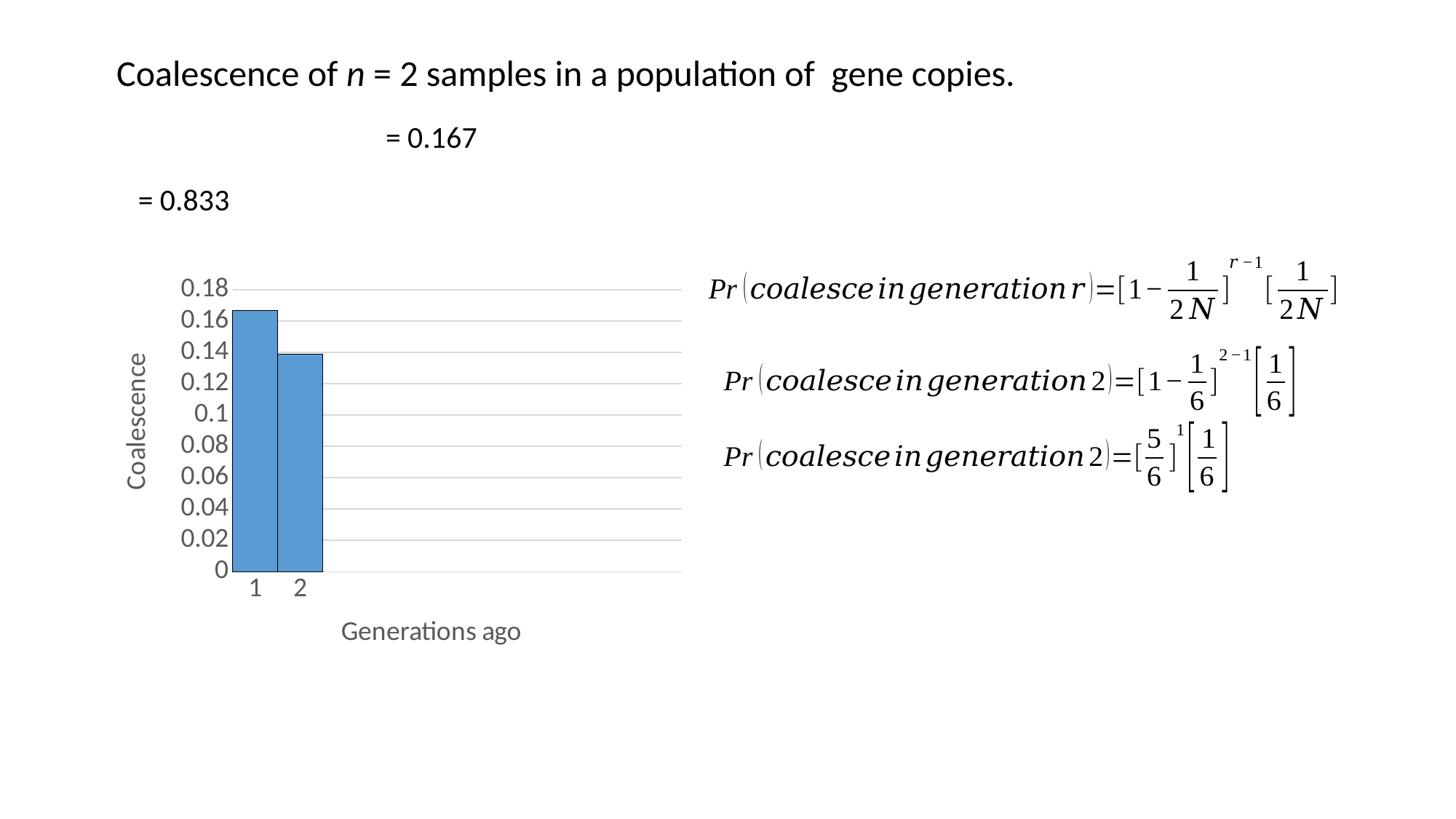
How many bars (categories) are plotted in the chart? 2 Which generation has the lowest coalescence value in the chart? 2 Is the coalescence value for generation 1 greater or less than 0.14? greater Do the coalescence values rise or fall from generation 1 to generation 2? fall Which bar is taller, generation 1 or generation 2? generation 1 What kind of chart is shown on the slide? bar chart What is the label of the y axis of the chart? Coalescence Is the coalescence value for generation 1 greater or less than 0.18? less What is the label of the x axis of the chart? Generations ago Which generation has the highest coalescence value in the chart? 1 Is the coalescence value for generation 2 greater or less than 0.12? greater